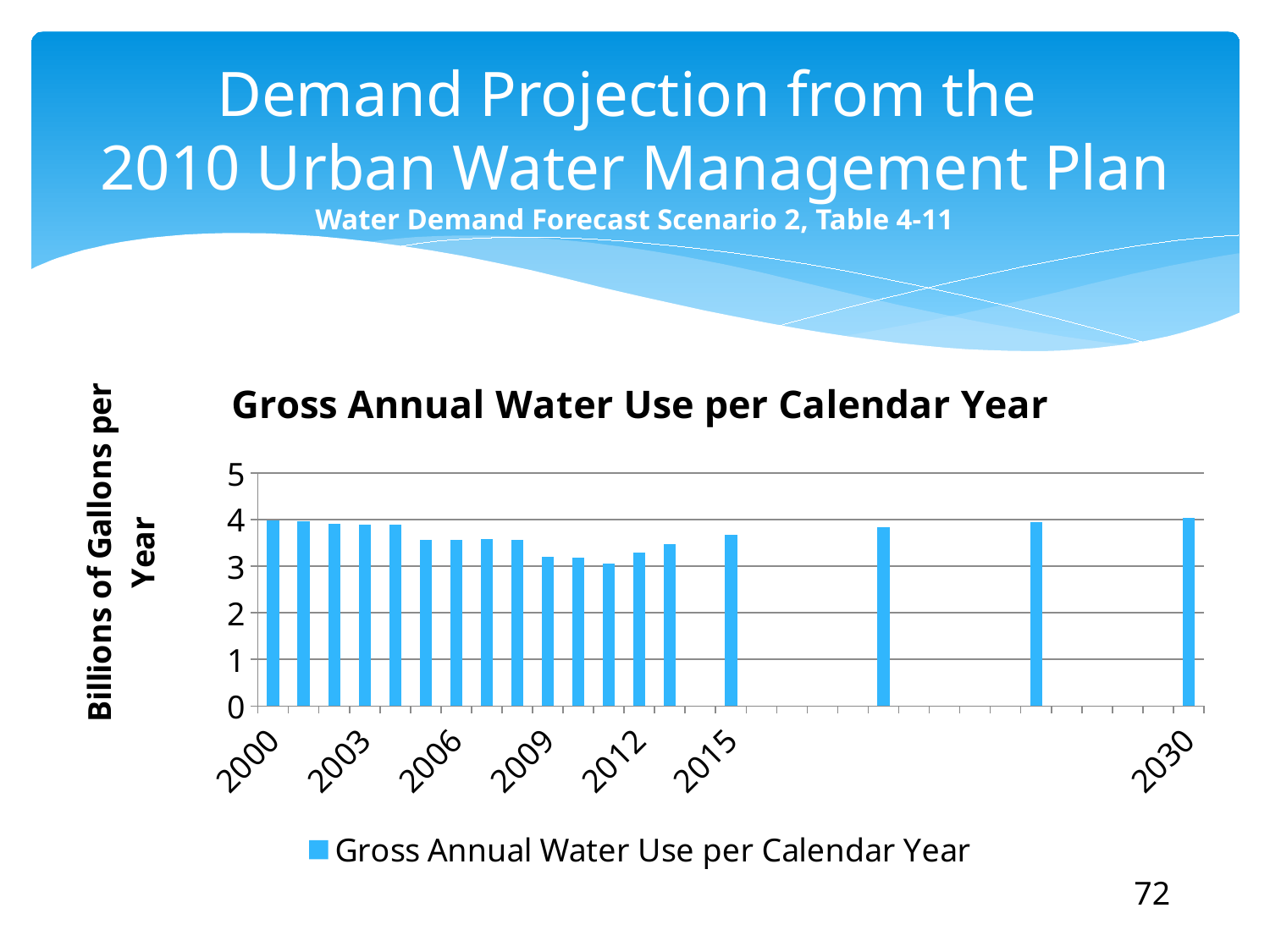
Is the value for 2015 greater or less than 3? greater How many bars are plotted in the chart? 18 Is the value for 2009 greater or less than 4? less Is the value for 2000 greater or less than 3? greater What is the title of the chart? Gross Annual Water Use per Calendar Year Which is larger, the value for 2000 or the value for 2012? 2000 How many series does the legend list? 1 What is the label on the vertical axis of the chart? Billions of Gallons per Year Which is larger, the value for 2003 or the value for 2009? 2003 Do the values generally rise or fall from 2000 to 2009? fall What kind of chart is shown on the slide? bar chart